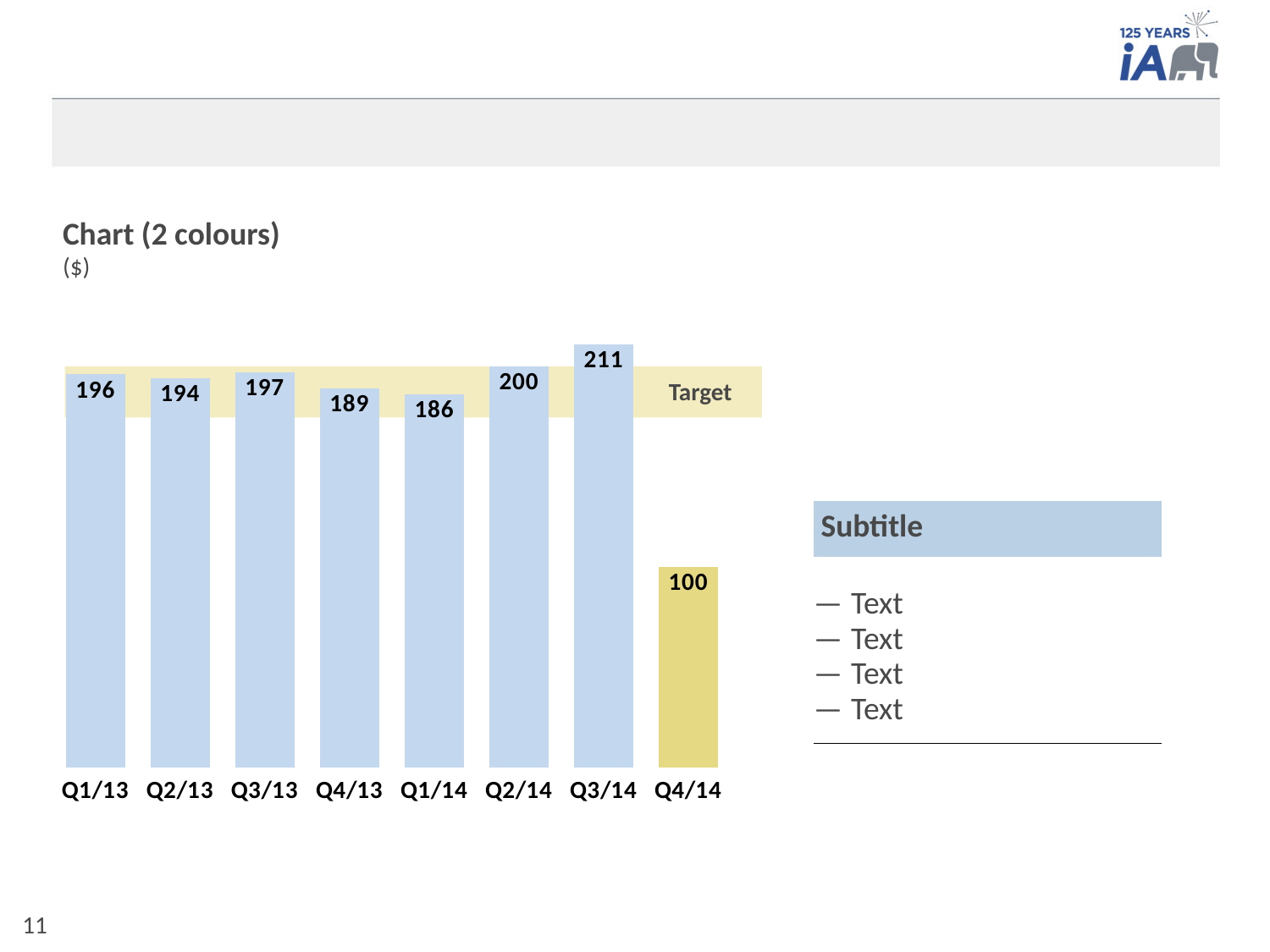
What label is shown on the horizontal band across the top of the bars? Target Which quarter has the highest value? Q3/14 Which quarter has the lowest value? Q4/14 What is the value for Q4/14? 100 What is the value for Q1/14? 186 What is the difference between the values for Q3/14 and Q1/14? 25 Which is larger, the value for Q2/13 or the value for Q4/13? Q2/13 What is the value for Q3/14? 211 What is the difference between the values for Q2/14 and Q4/14? 100 How many quarters are shown on the x axis? 8 What kind of chart is shown? bar chart What is the title of the chart? Chart (2 colours)